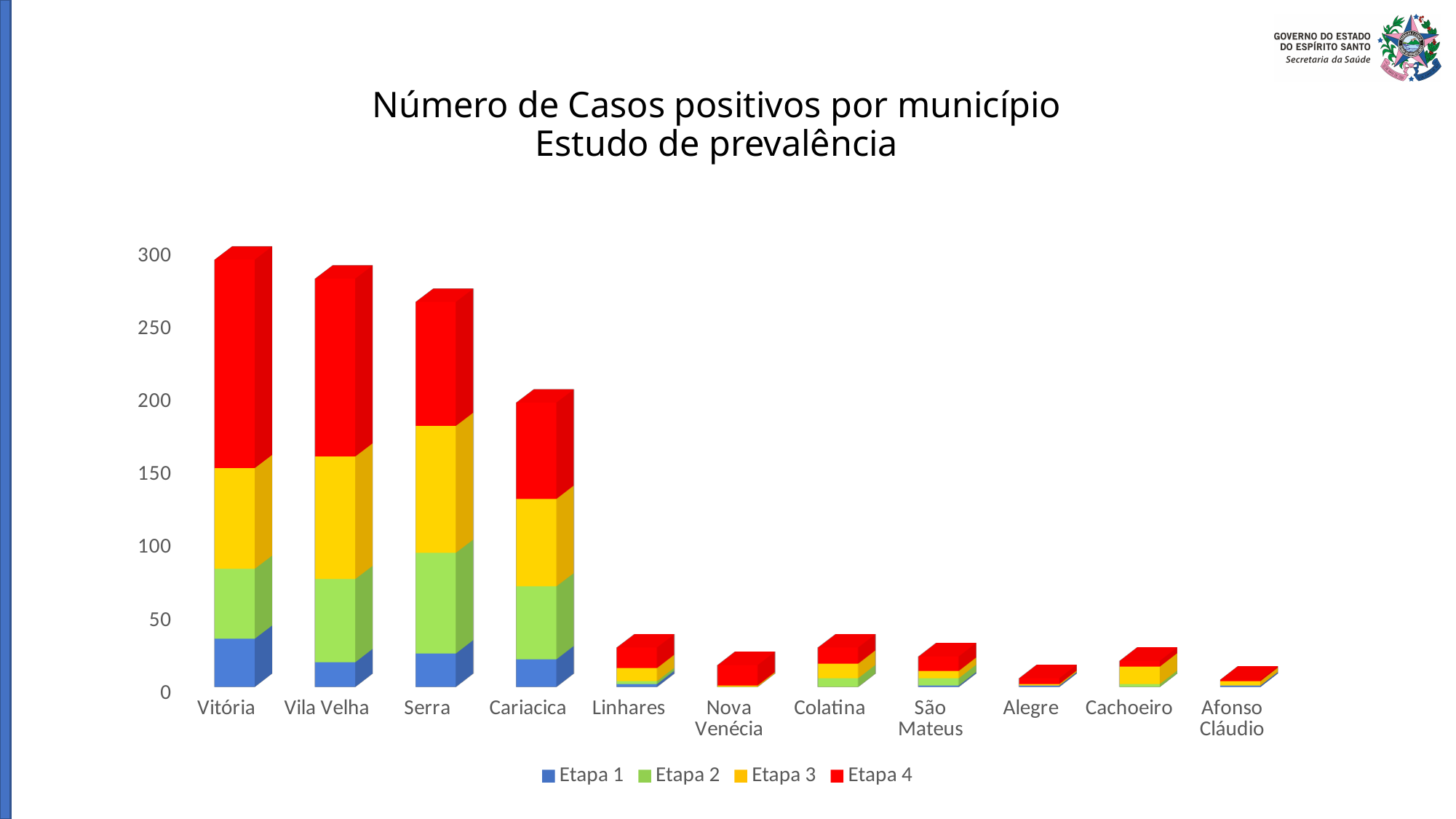
Which has a larger total of positive cases, Vitória or Cariacica? Vitória Which colour represents Etapa 4 in the legend? Red How many municipalities are shown on the x axis of the chart? 11 Is the total value for Linhares greater or less than 50? less What is the title of the chart? Número de Casos positivos por município Estudo de prevalência Which has a larger total of positive cases, Serra or Linhares? Serra Do the total values rise or fall from Vitória to Cariacica across the first four municipalities? fall How many series does the legend list? 4 Is the total value for Vitória greater or less than 250? greater Is the total value for Cariacica greater or less than 250? less Which municipality has the highest total number of positive cases? Vitória What kind of chart is shown on the slide? Stacked bar chart